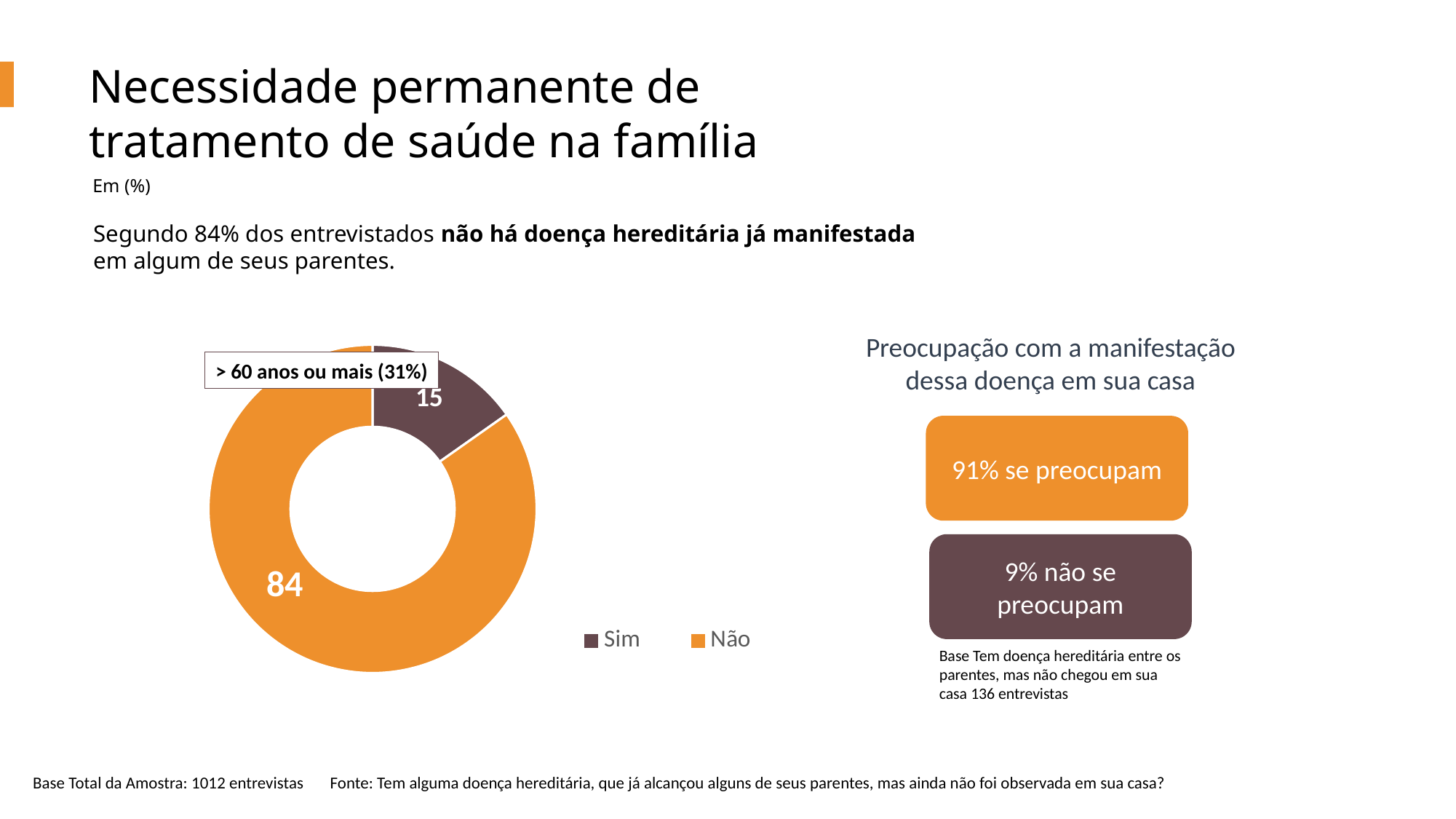
How many entries does the legend of the donut chart list? 2 What is the value for "Sim" in the donut chart? 15 What colour is the "Não" segment in the donut chart? Orange Which is larger in the donut chart, "Sim" or "Não"? Não Which category has the smallest share of the donut chart? Sim What is the value for "Não" in the donut chart? 84 What does the callout label attached to the "Sim" segment of the donut chart say? > 60 anos ou mais (31%) How many categories does the donut chart show? 2 Which category has the largest share of the donut chart? Não What is the difference between the values for "Não" and "Sim" in the donut chart? 69 What kind of chart is shown on the slide? Donut chart